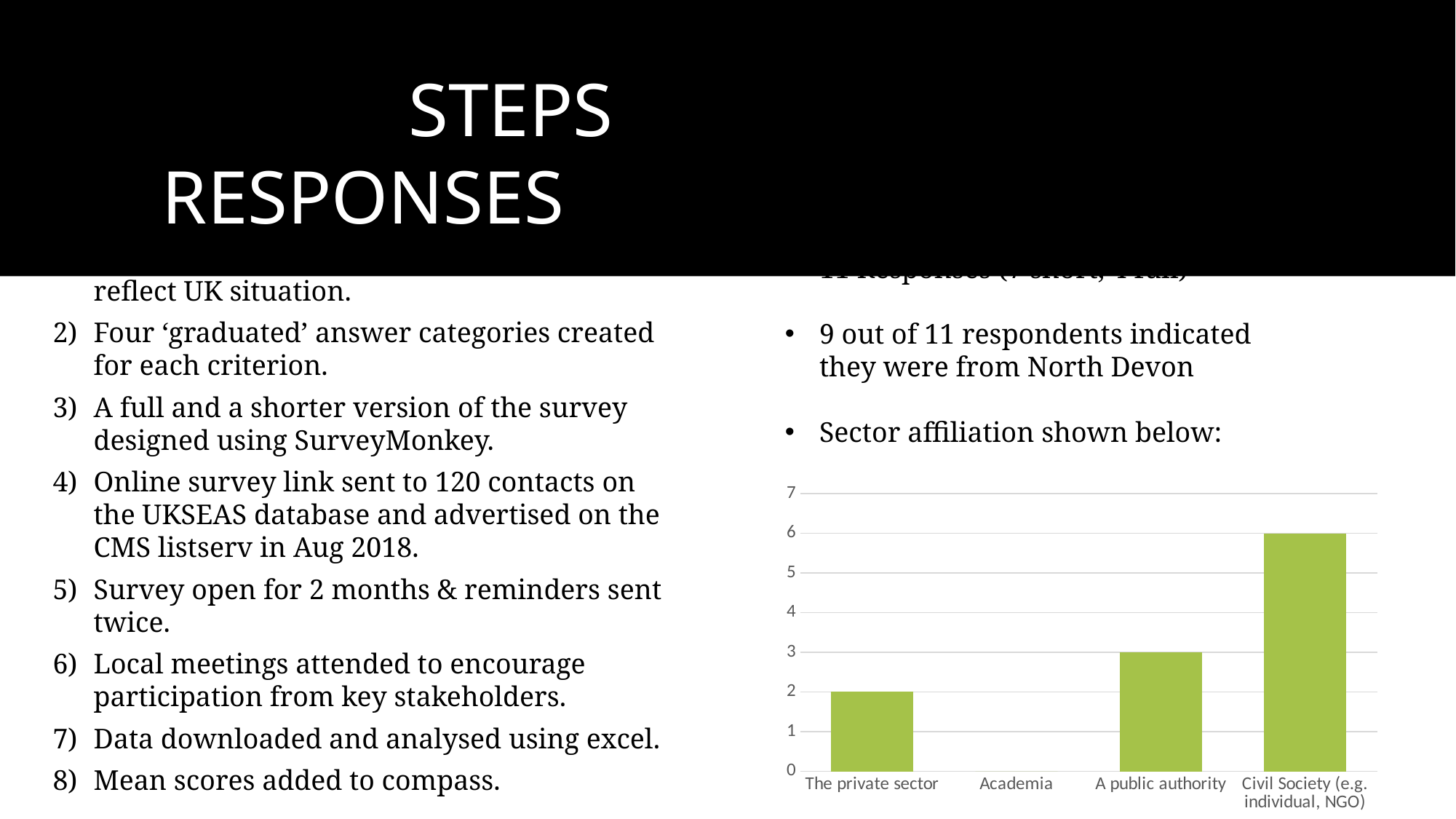
What is the value for A public authority in the chart? 3 What is the value for The private sector in the chart? 2 What kind of chart is shown on the slide? bar chart What is the maximum value shown on the vertical axis of the chart? 7 Which category has the highest value in the chart? Civil Society (e.g. individual, NGO) Which category has the lowest value in the chart? Academia Which is larger, the value for The private sector or the value for A public authority? A public authority What is the difference between the values for Civil Society (e.g. individual, NGO) and A public authority? 3 How many categories are shown on the x axis of the chart? 4 What is the value for Civil Society (e.g. individual, NGO) in the chart? 6 Is the value for Civil Society (e.g. individual, NGO) greater or less than 5? greater What colour are the bars in the chart? green